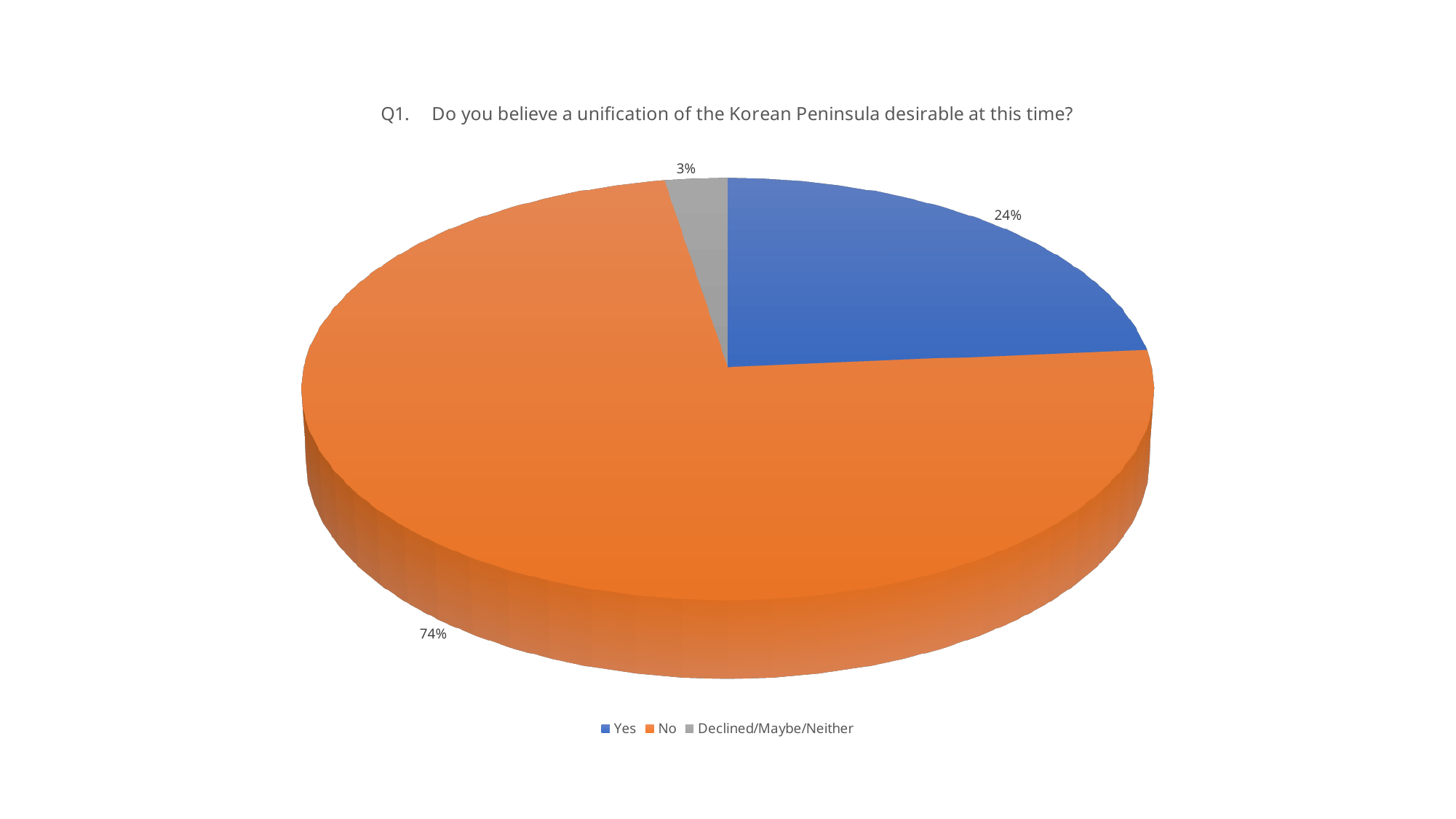
Which response has the largest share of the pie? No Which response has the smallest share of the pie? Declined/Maybe/Neither How many entries does the legend list? 3 How many categories does the pie chart show? 3 What percentage of respondents answered "No"? 74% What type of chart is shown on the slide? Pie chart What percentage of respondents are in the "Declined/Maybe/Neither" category? 3% Which is larger, the share for "Yes" or the share for "Declined/Maybe/Neither"? Yes What percentage of respondents answered "Yes"? 24% What is the title of the chart? Q1. Do you believe a unification of the Korean Peninsula desirable at this time? What is the difference in percentage points between the "No" and "Yes" responses? 50 What colour represents the "No" response in the pie chart? Orange